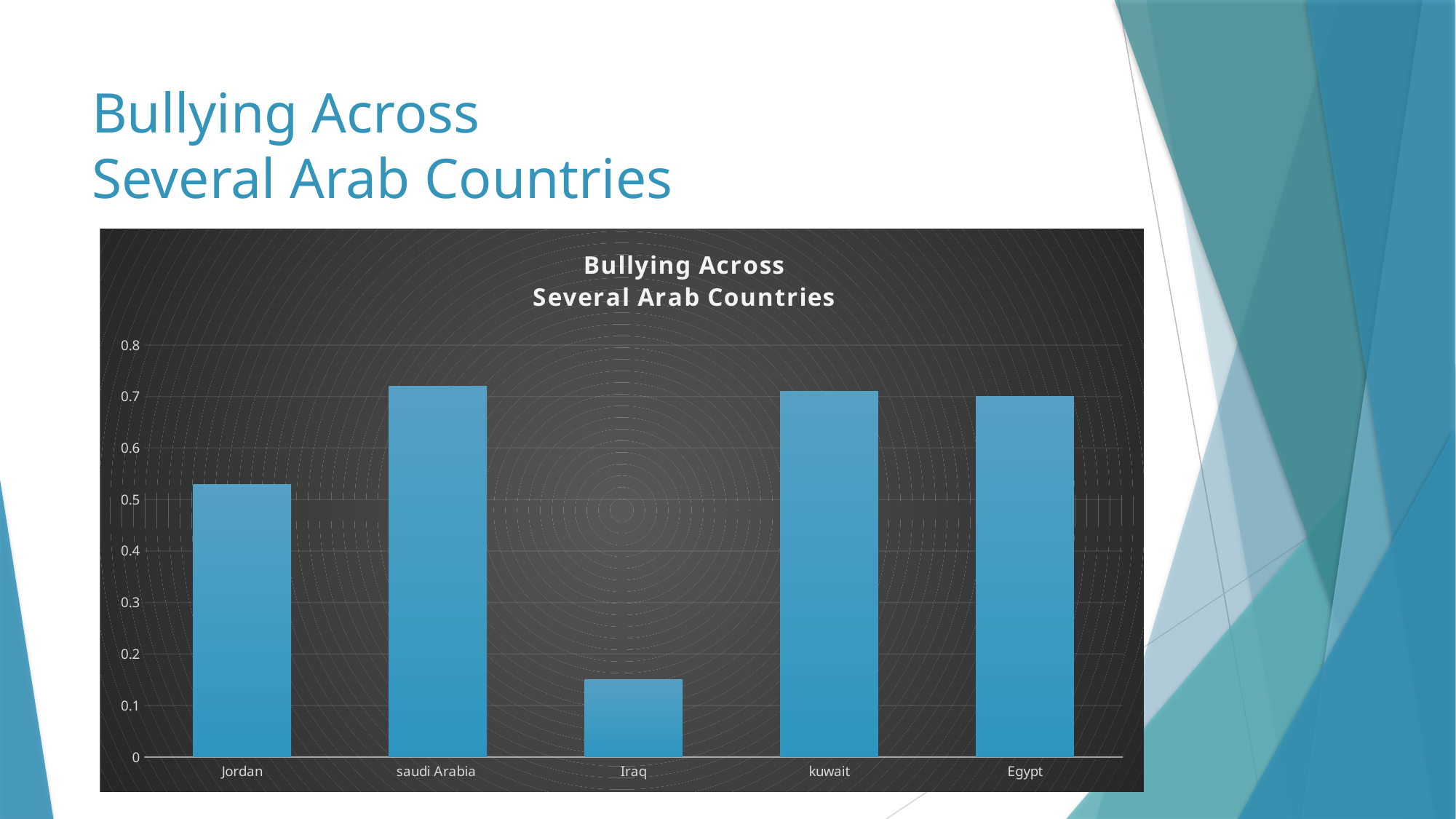
What is the title of the chart? Bullying Across Several Arab Countries Is the value for Iraq greater or less than 0.2? less Which has a larger value, Jordan or Iraq? Jordan Is the value for kuwait greater or less than 0.6? greater Which country has the lowest value in the chart? Iraq How many countries are shown on the x axis of the chart? 5 Is the value for Jordan greater or less than 0.6? less Which has a larger value, Jordan or saudi Arabia? saudi Arabia Which has a larger value, Iraq or Egypt? Egypt What kind of chart is shown on the slide? bar chart